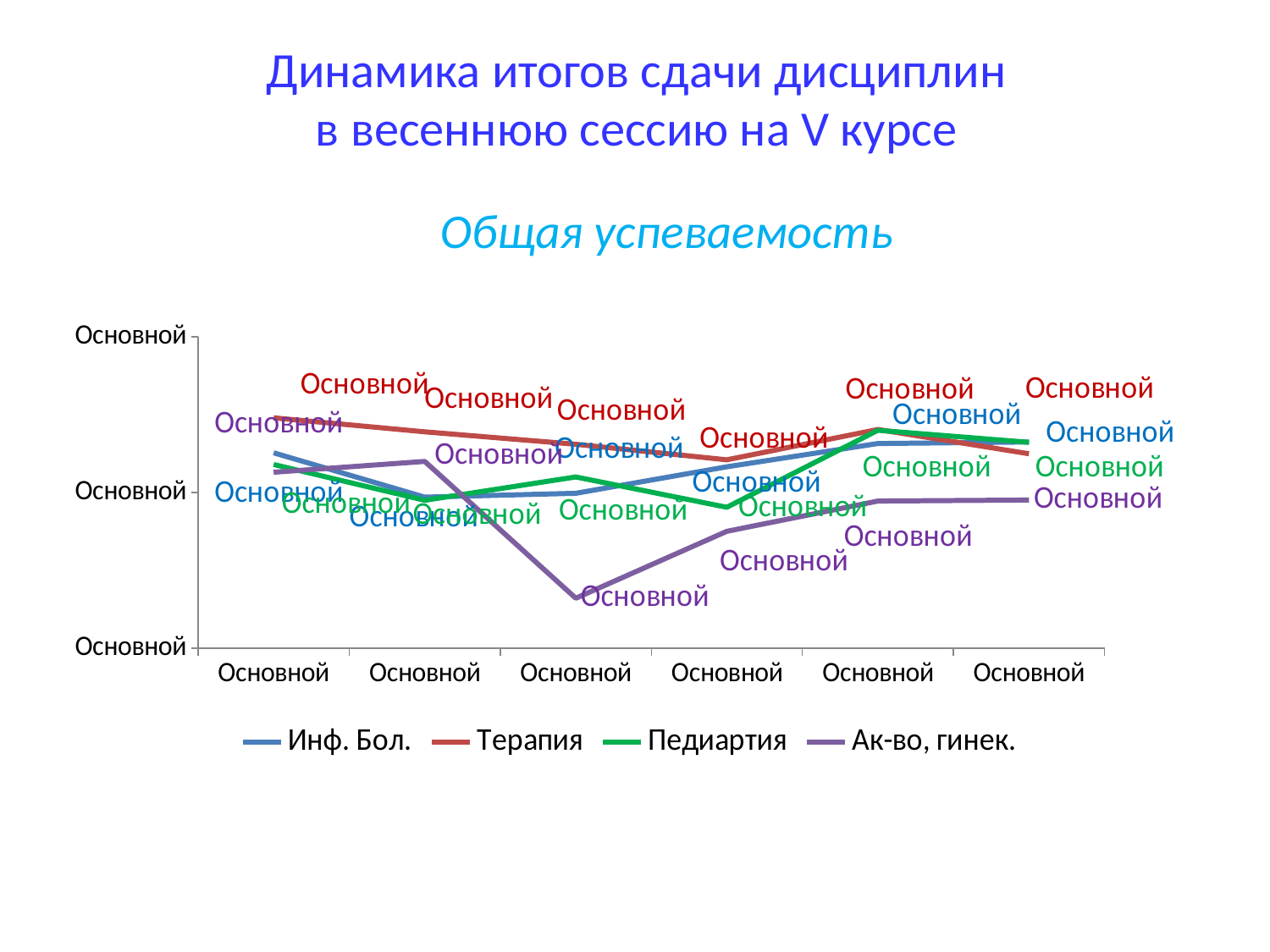
Which series drops to the lowest point anywhere on the chart? Ак-во, гинек. What is the title of the chart? Общая успеваемость Does the Терапия line generally rise or fall from the first point to the fourth point? fall Does the Ак-во, гинек. line rise or fall from the third point to the fifth point? rise How many points are plotted along the x axis for each series? 6 At the first point on the x axis, which is higher: Терапия or Инф. Бол.? Терапия What kind of chart is shown on the slide? line chart At the third point on the x axis, which is lower: Ак-во, гинек. or Педиартия? Ак-во, гинек. Which series is drawn with the red line? Терапия How many series does the legend list? 4 Which series is highest at the first point on the x axis? Терапия